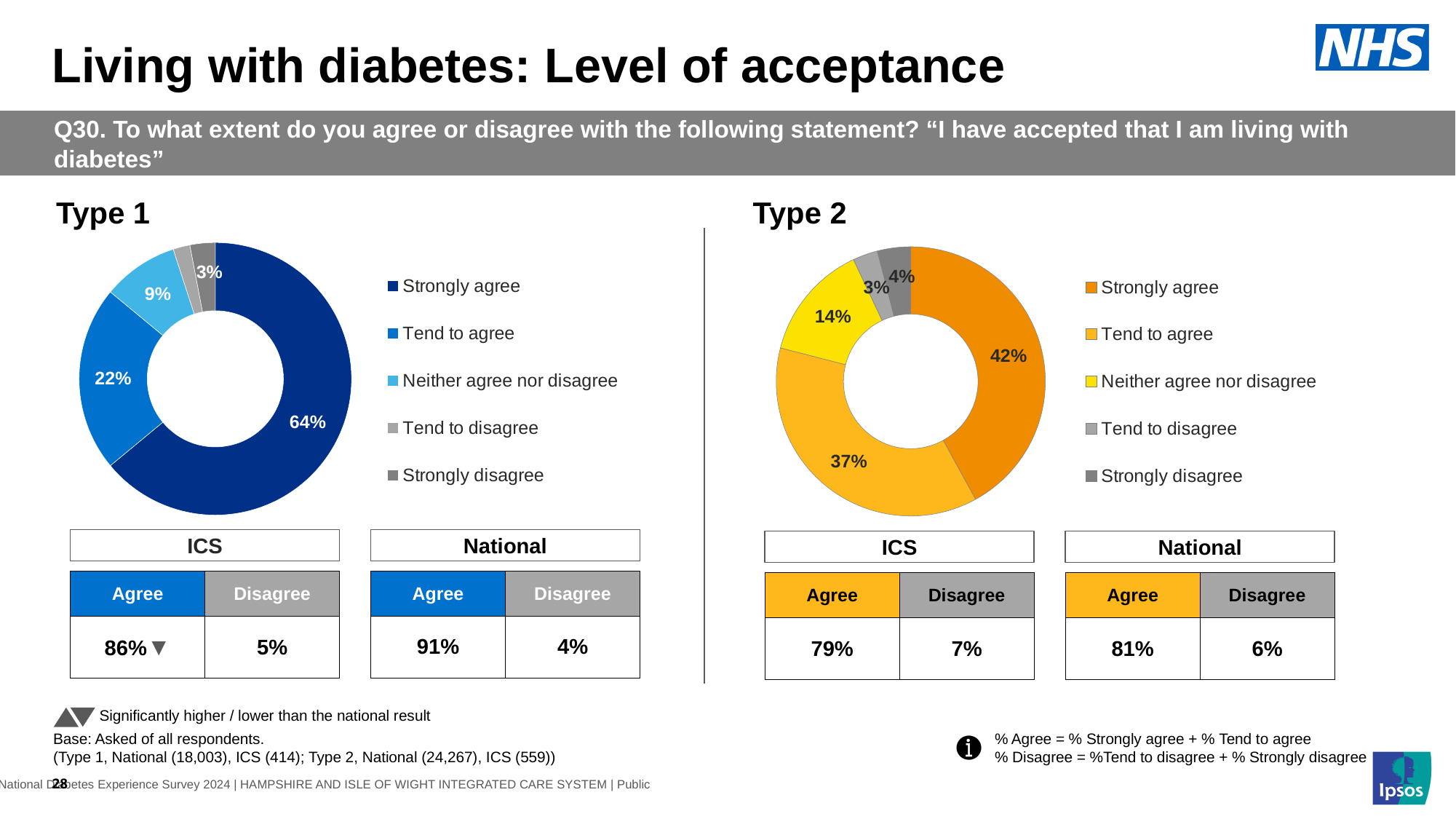
In the Type 1 chart, what percentage is shown for Strongly agree? 64% In the Type 1 chart, which is larger: Tend to agree or Neither agree nor disagree? Tend to agree In the Type 2 chart, what percentage is shown for Strongly disagree? 4% In the Type 2 chart, which category has the largest share? Strongly agree In the Type 1 chart, which category has the largest share? Strongly agree In the Type 2 chart, what is the difference between Strongly agree and Tend to agree? 5% In the Type 2 chart, what percentage is shown for Strongly agree? 42% In the Type 1 chart, what percentage is shown for Tend to agree? 22% In the Type 1 chart, what percentage is shown for Neither agree nor disagree? 9% What kind of chart is used for Type 1? Donut (pie) chart In the Type 2 chart, what percentage is shown for Neither agree nor disagree? 14% How many categories does the legend of the Type 2 chart list? 5